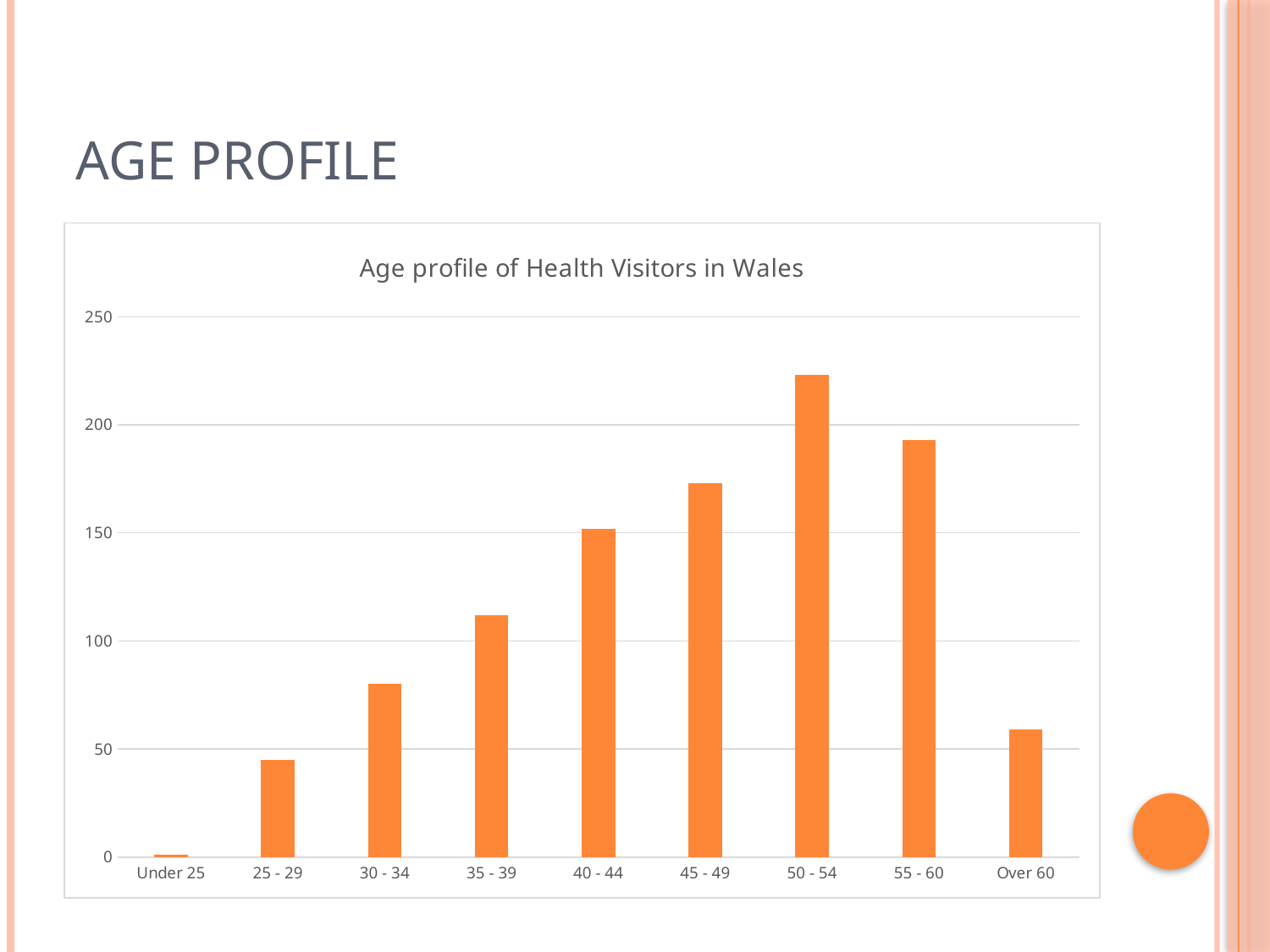
Is the value for 55 - 60 greater or less than 200? less Is the value for Over 60 greater or less than 50? greater What is the title of the chart? Age profile of Health Visitors in Wales What type of chart is shown on the slide? bar chart How many age categories are shown on the x axis? 9 Do the values rise or fall from Under 25 to 50 - 54? rise Which age category has the highest value? 50 - 54 Which has a larger value, 45 - 49 or 55 - 60? 55 - 60 Is the value for 50 - 54 greater or less than 200? greater Which age category has the lowest value? Under 25